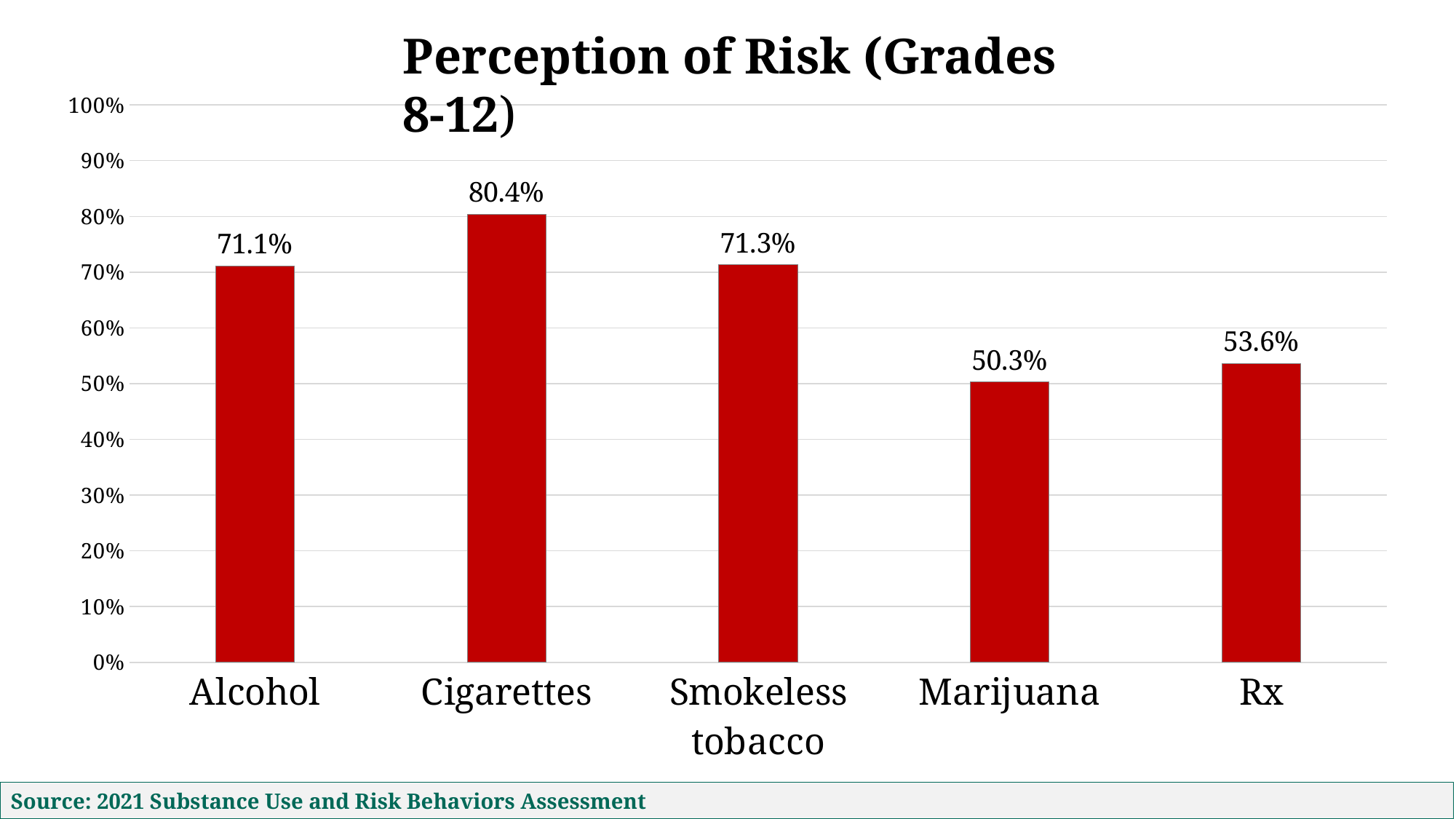
Is the value for Alcohol greater or less than 70%? greater What is the difference between the values for Cigarettes and Marijuana? 30.1% Which is larger, the value for Alcohol or the value for Rx? Alcohol What kind of chart is shown on the slide? Bar chart What is the value for Marijuana? 50.3% How many categories are shown in the chart? 5 What is the value for Smokeless tobacco? 71.3% What is the difference between the values for Rx and Marijuana? 3.3% Which category has the highest value? Cigarettes What is the value for Rx? 53.6% What is the value for Cigarettes? 80.4% Which category has the lowest value? Marijuana